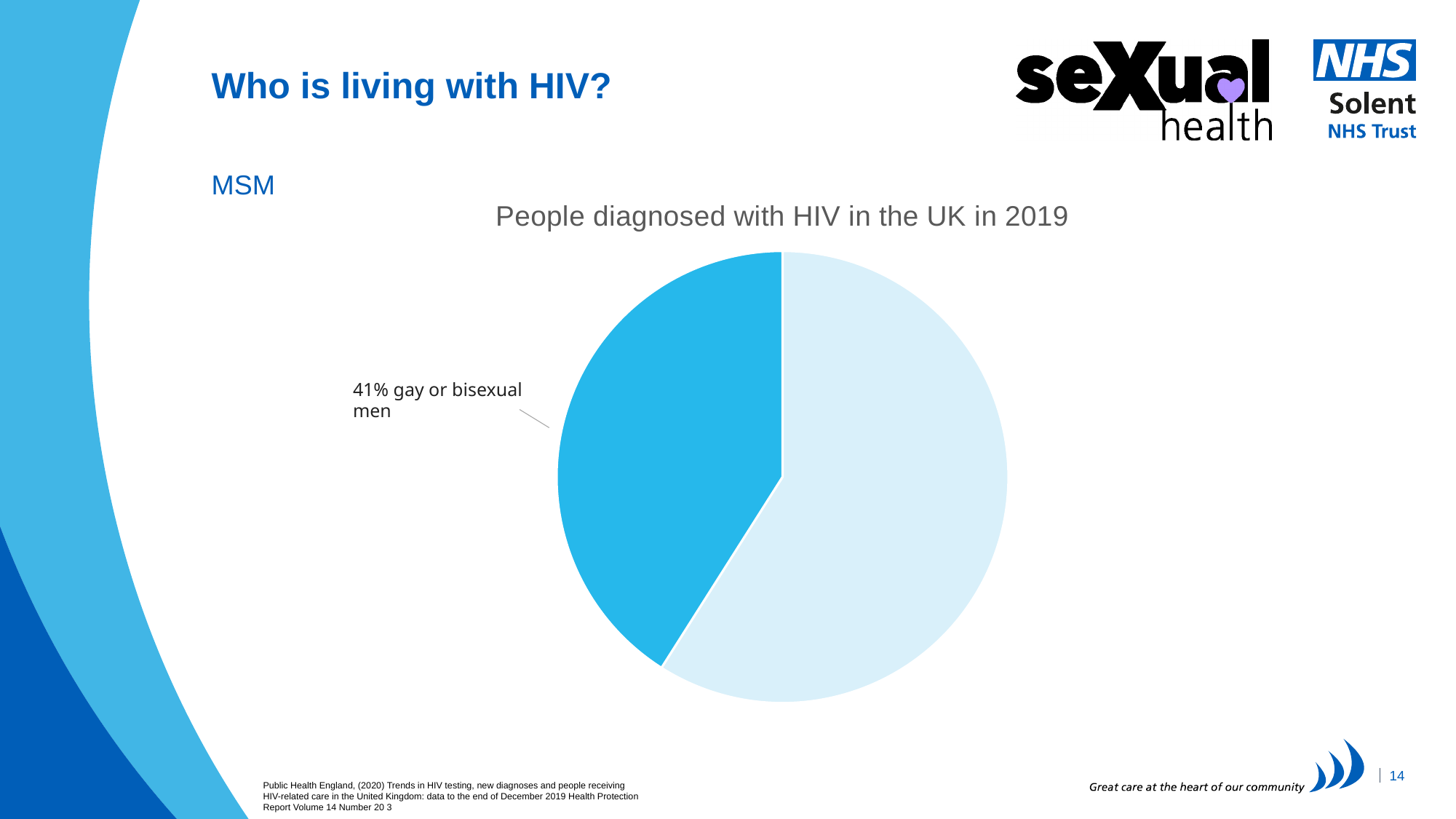
What is the title of the chart? People diagnosed with HIV in the UK in 2019 What share of the pie is labelled as gay or bisexual men? 41% How many slices of the pie chart have a printed data label? 1 What kind of chart is shown on the slide? pie chart Is the slice for gay or bisexual men greater or less than 50% of the pie? less How many slices does the pie chart have? 2 Which slice is larger: the darker blue slice labelled gay or bisexual men, or the lighter unlabelled slice? the lighter unlabelled slice What colour is the slice labelled 41% gay or bisexual men? darker blue